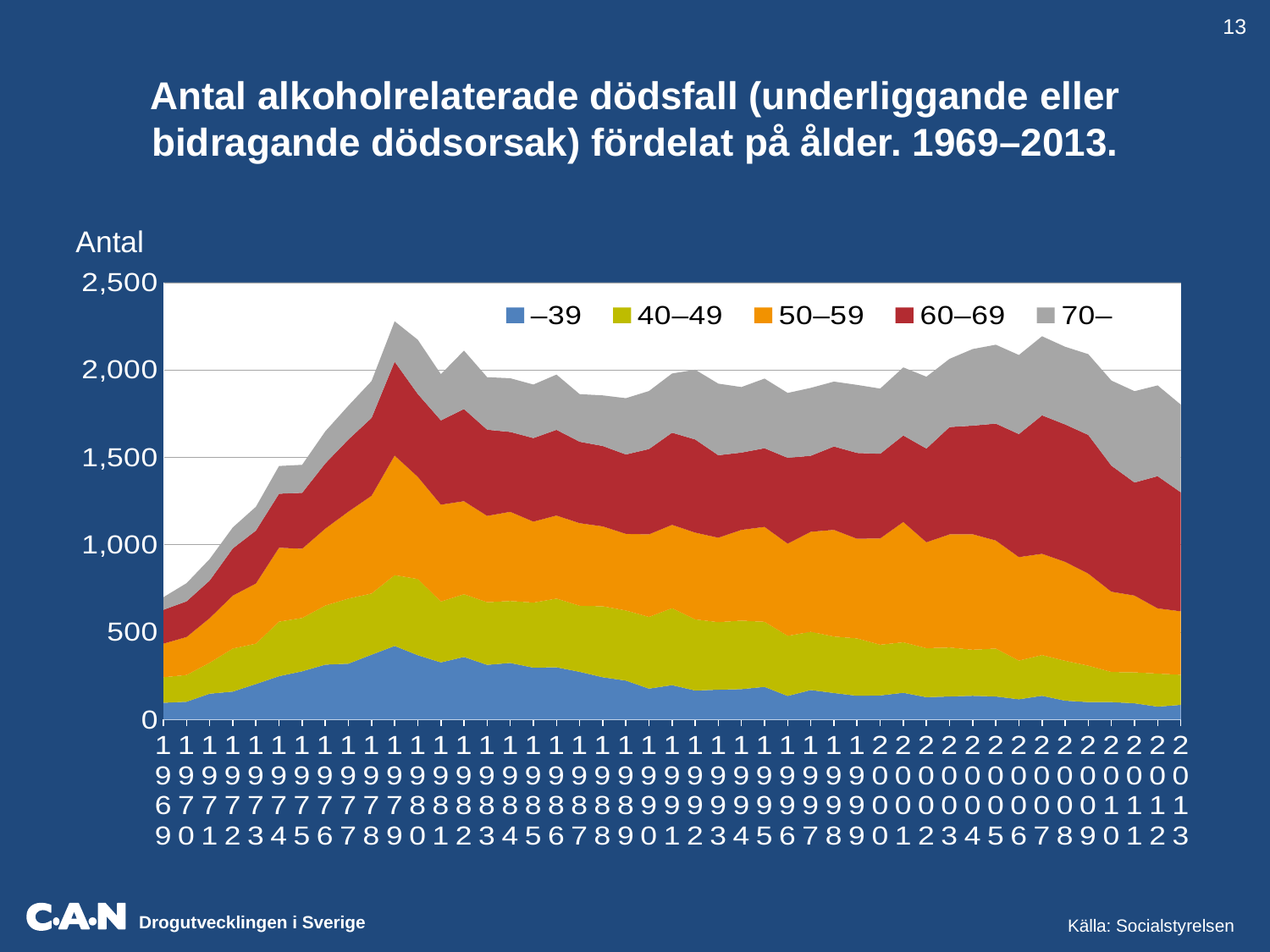
Is the total number of alcohol-related deaths in 1969 greater or less than 1,000? less What is the source cited for the chart? Socialstyrelsen Which age group is shown in grey in the legend? 70– Which is larger, the total number of deaths in 1969 or in 2013? 2013 Does the number of deaths in the –39 age group rise or fall from 1980 to 2013? Fall Is the value for the –39 age group in 1980 greater or less than 500? less What kind of chart is shown on the slide? Stacked area chart How many years are plotted along the x axis? 45 How many age-group series does the legend list? 5 Which year has the lowest total number of alcohol-related deaths? 1969 Is the total number of alcohol-related deaths in 1980 greater or less than 2,000? greater